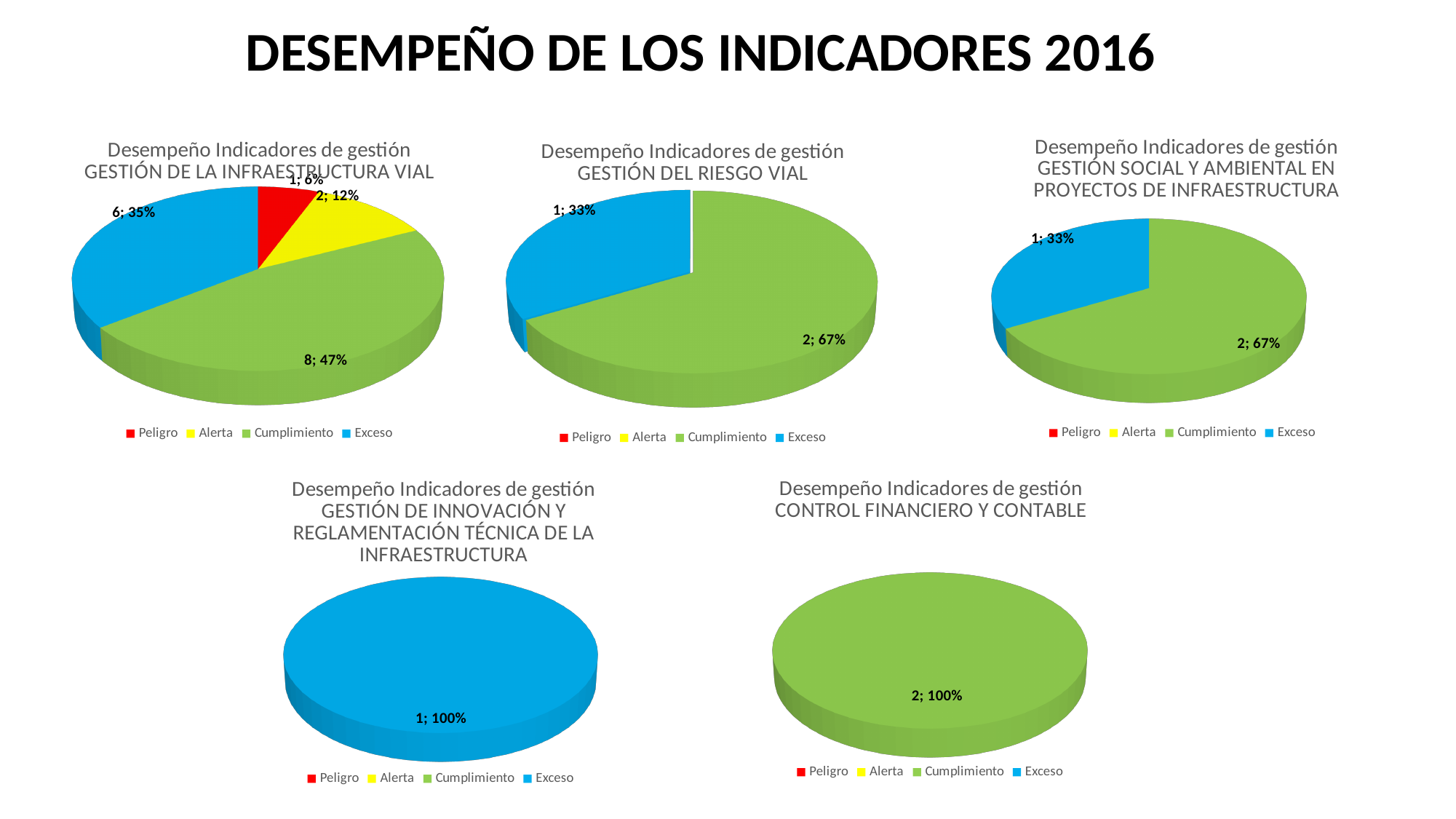
In the 'GESTIÓN DE LA INFRAESTRUCTURA VIAL' chart, what is the difference in count between Cumplimiento and Exceso? 2 In the 'GESTIÓN DE LA INFRAESTRUCTURA VIAL' chart, which category has the smallest slice? Peligro In the 'GESTIÓN DE INNOVACIÓN Y REGLAMENTACIÓN TÉCNICA DE LA INFRAESTRUCTURA' chart, what share of the pie is Exceso? 100% In the 'GESTIÓN SOCIAL Y AMBIENTAL EN PROYECTOS DE INFRAESTRUCTURA' chart, what is the count shown for Cumplimiento? 2 In the 'GESTIÓN DE LA INFRAESTRUCTURA VIAL' chart, which category has the largest slice? Cumplimiento In the 'GESTIÓN DE LA INFRAESTRUCTURA VIAL' chart, what is the count shown for Exceso? 6 In the 'GESTIÓN DE LA INFRAESTRUCTURA VIAL' chart, how many slices does the pie have? 4 In the 'GESTIÓN DEL RIESGO VIAL' chart, what share of the pie is Exceso? 33% In the 'CONTROL FINANCIERO Y CONTABLE' chart, what is the count shown for Cumplimiento? 2 In the 'GESTIÓN DEL RIESGO VIAL' chart, which is larger, Cumplimiento or Exceso? Cumplimiento What kind of chart is used for 'CONTROL FINANCIERO Y CONTABLE'? Pie chart In the 'GESTIÓN DE LA INFRAESTRUCTURA VIAL' chart, what share of the pie is Cumplimiento? 47%